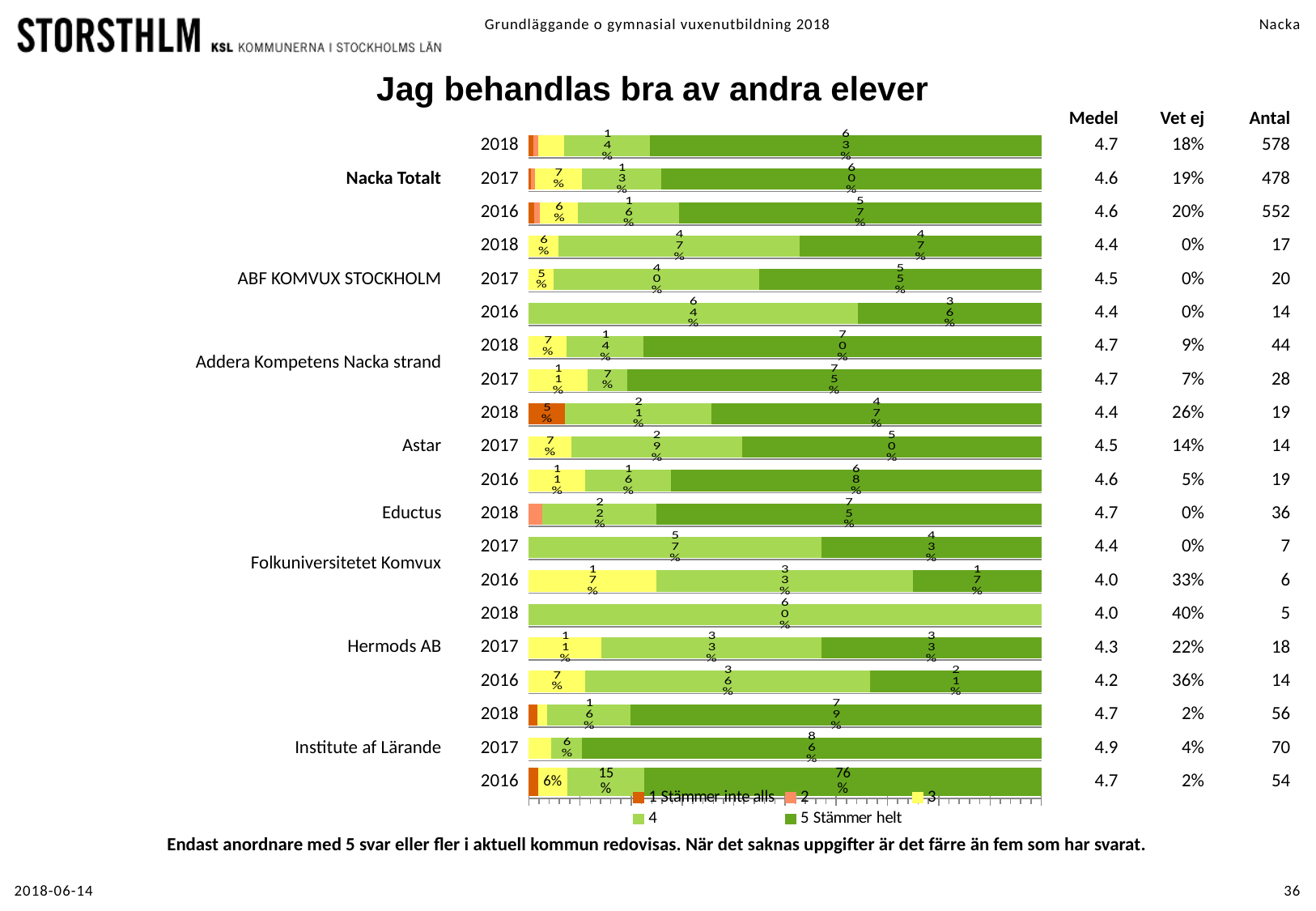
For Institute af Lärande, which year has the highest share of '5 Stämmer helt'? 2017 What is the title of the chart? Jag behandlas bra av andra elever What is the share of '4' for Institute af Lärande in 2016? 15% What is the share of '5 Stämmer helt' for Addera Kompetens Nacka strand in 2017? 75% What kind of chart is shown on the slide? bar chart What is the share of '4' for Hermods AB in 2018? 60% What is the share of '5 Stämmer helt' for Nacka Totalt in 2018? 63% By how many percentage points does the '5 Stämmer helt' share for Nacka Totalt in 2018 exceed that in 2017? 3 For Folkuniversitetet Komvux in 2017, which is larger: the share of '4' or the share of '5 Stämmer helt'? 4 Does the '5 Stämmer helt' share for Nacka Totalt rise or fall from 2016 to 2018? rise How many series does the legend list? 5 What is the share of '5 Stämmer helt' for Institute af Lärande in 2017? 86%